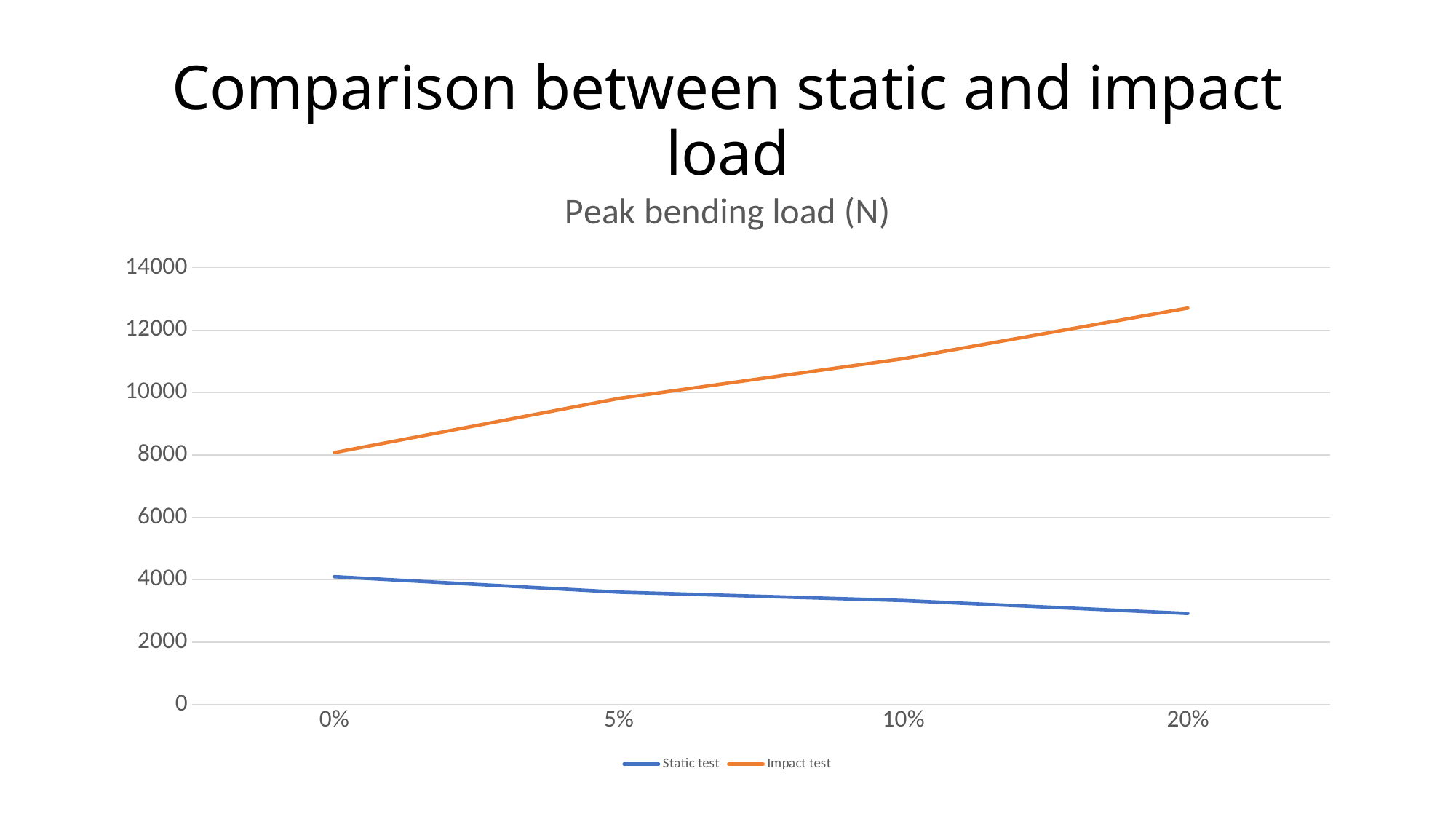
Is the Impact test value at 20% greater or less than 12000? greater Which series has the higher value at 10%, Static test or Impact test? Impact test What kind of chart is shown on the slide? line chart How many series does the legend list? 2 What is the title of the chart? Peak bending load (N) At which category is the Impact test value highest? 20% Which series is shown in orange? Impact test Does the Static test series rise or fall from 0% to 20%? fall Does the Impact test series rise or fall from 0% to 20%? rise How many categories are shown on the x axis? 4 Is the Impact test value at 0% greater or less than 10000? less Is the Static test value at 20% greater or less than 4000? less